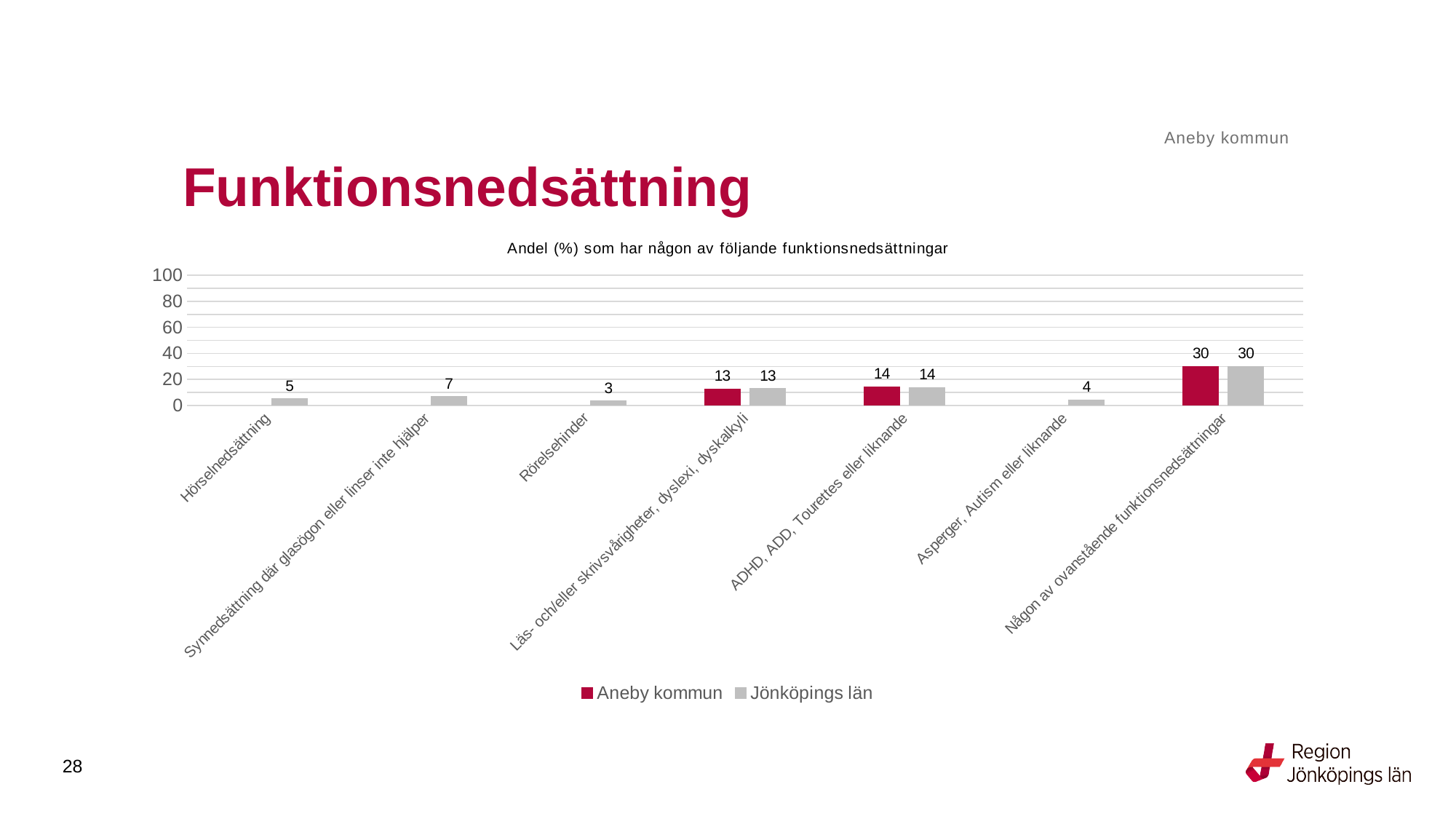
What is the value for Aneby kommun for ADHD, ADD, Tourettes eller liknande? 14 Which category has the highest value for Jönköpings län? Någon av ovanstående funktionsnedsättningar Is the value for Aneby kommun for Någon av ovanstående funktionsnedsättningar greater or less than 20? greater What is the value for Jönköpings län for Asperger, Autism eller liknande? 4 How many categories are shown on the x axis? 7 Which is larger for Jönköpings län: Synnedsättning där glasögon eller linser inte hjälper or Rörelsehinder? Synnedsättning där glasögon eller linser inte hjälper What kind of chart is shown on the slide? bar chart What is the value for Jönköpings län for Synnedsättning där glasögon eller linser inte hjälper? 7 How many series does the legend list? 2 Which category has the lowest value for Jönköpings län? Rörelsehinder What is the difference between the Jönköpings län values for Någon av ovanstående funktionsnedsättningar and ADHD, ADD, Tourettes eller liknande? 16 What is the value for Jönköpings län for Hörselnedsättning? 5